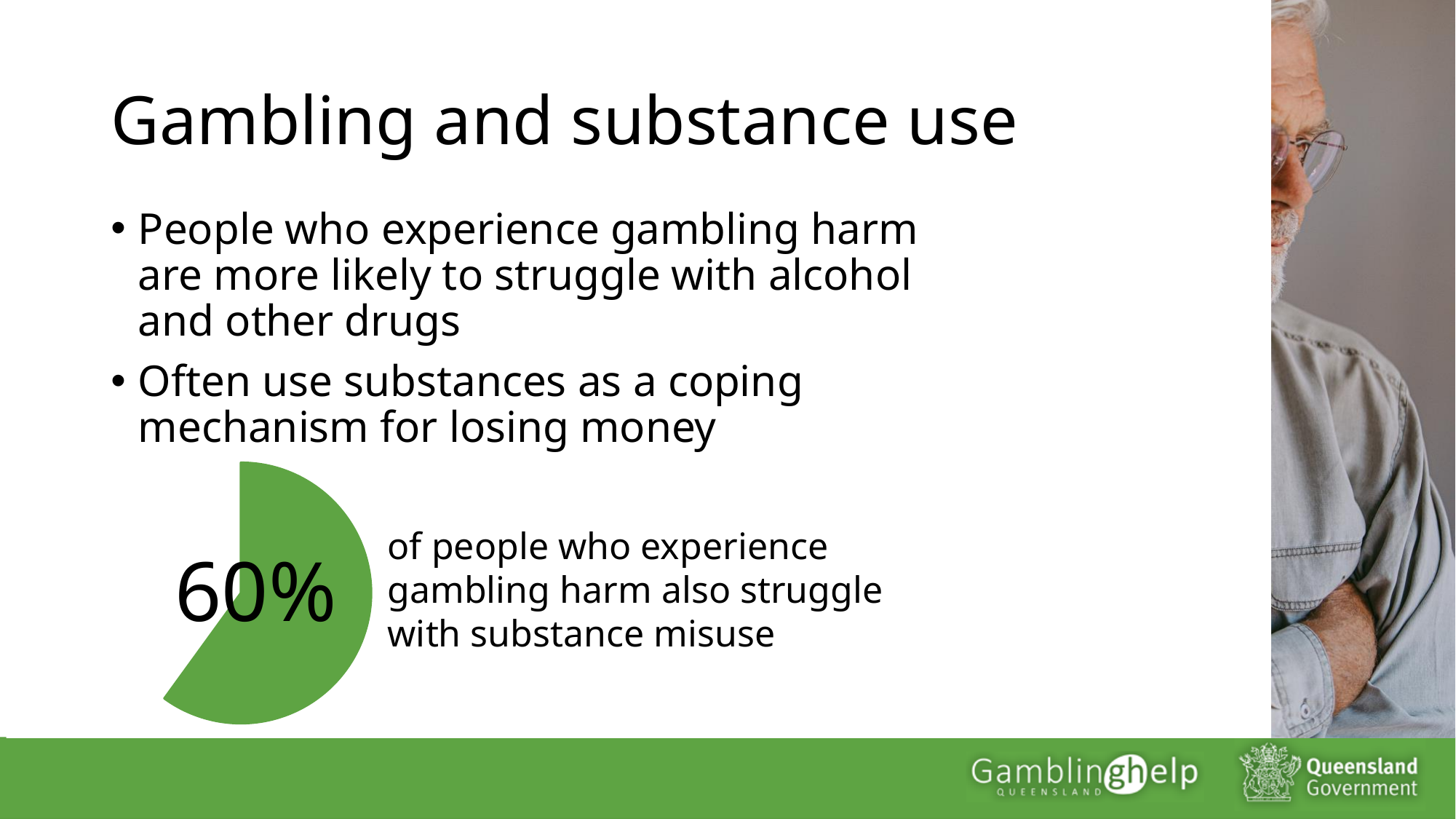
Does the green slice of the pie chart cover more or less than half of the pie? more What colour is the filled slice of the pie chart? green What kind of chart is shown on the slide? pie chart Is the value shown in the pie chart greater or less than 75%? less Is the value shown in the pie chart greater or less than 50%? greater What percentage of people who experience gambling harm also struggle with substance misuse, according to the pie chart? 60% What share of the pie does the green slice represent? 60% What is the title of the slide containing the pie chart? Gambling and substance use